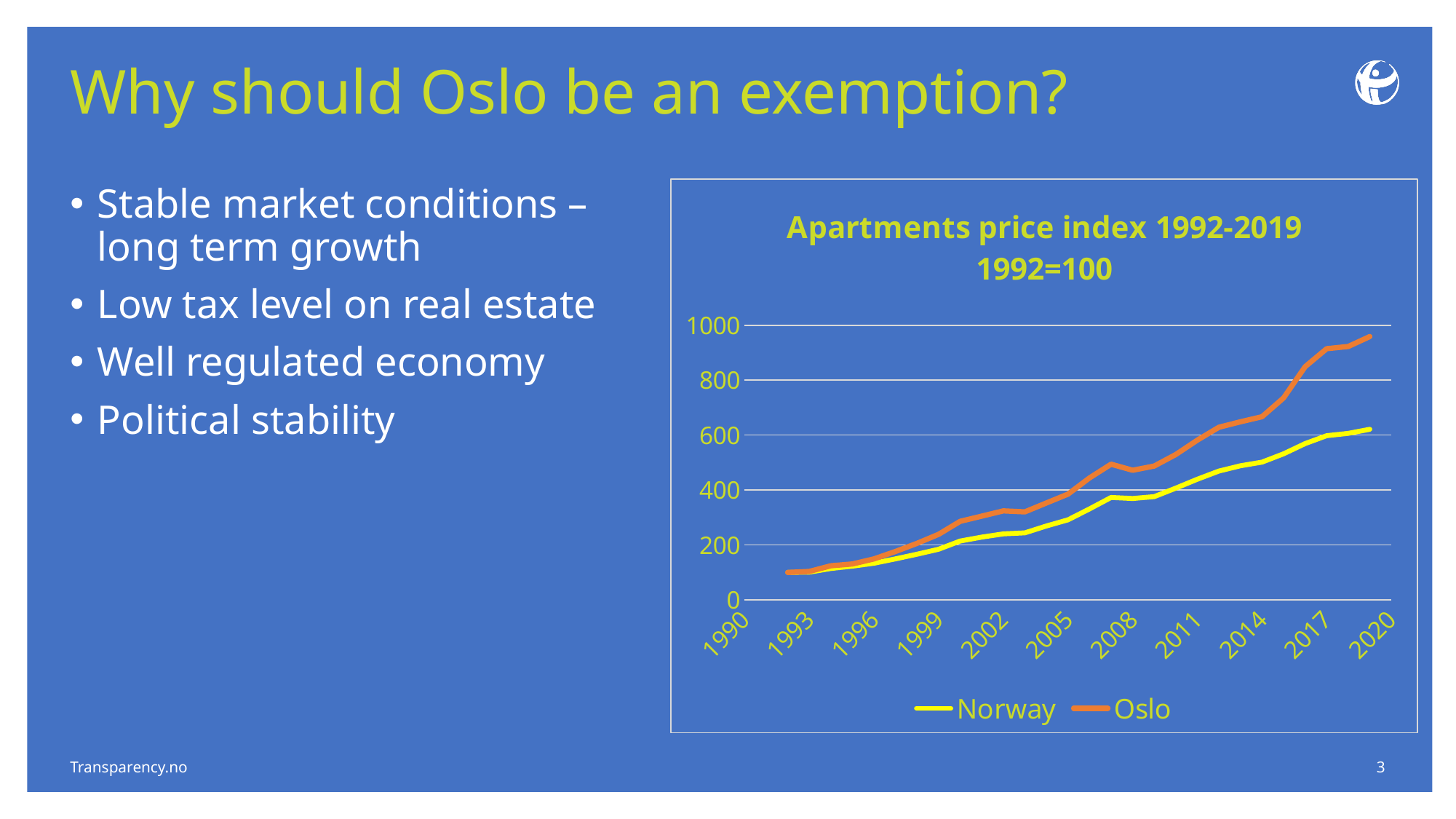
What is the title of the chart? Apartments price index 1992-2019 1992=100 Do the values for Oslo generally rise or fall from 1992 to 2019? rise Which series is drawn in orange in the chart? Oslo How many series does the chart's legend list? 2 What kind of chart is shown on the slide? line chart Is the value for Oslo in 2019 greater or less than 800? greater Do the values for Norway generally rise or fall from 1992 to 2019? rise Which series has the higher value in 2019, Norway or Oslo? Oslo How many year labels are shown on the x axis? 11 Is the value for Oslo in 2008 greater or less than 400? greater Is the value for Norway in 2014 greater or less than 600? less